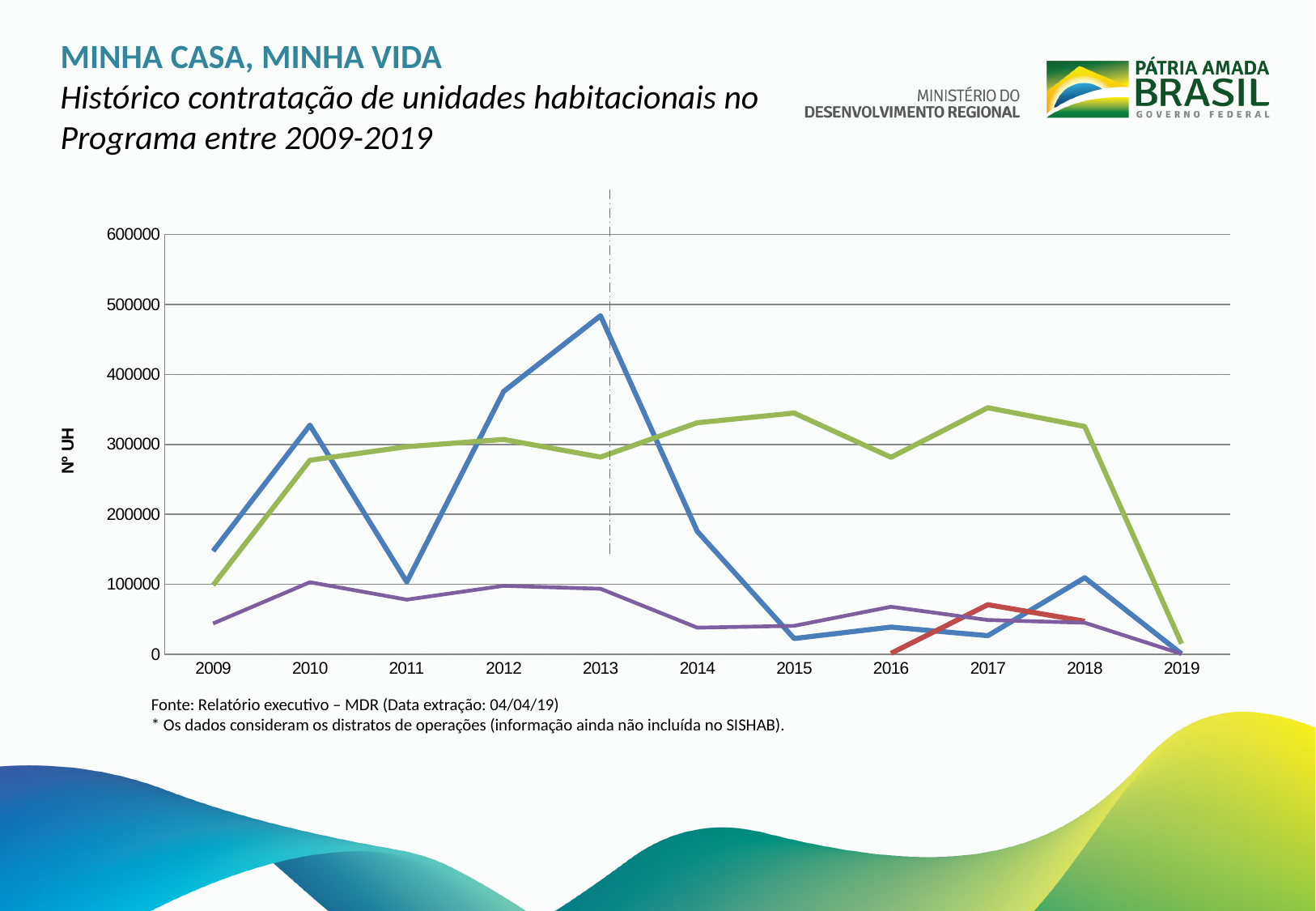
In which year does the blue line reach its highest value? 2013 In 2013, which line has the higher value, the blue line or the green line? the blue line Does the green line rise or fall between 2018 and 2019? fall In 2015, which line has the higher value, the blue line or the green line? the green line Is the value of the blue line in 2010 greater or less than 300000? greater Is the value of the green line in 2019 greater or less than 100000? less In which year does the green line reach its lowest value? 2019 Is the value of the blue line in 2015 greater or less than 100000? less What kind of chart is shown on the slide? line chart How many years are shown on the x axis of the chart? 11 What is the label on the y axis of the chart? Nº UH